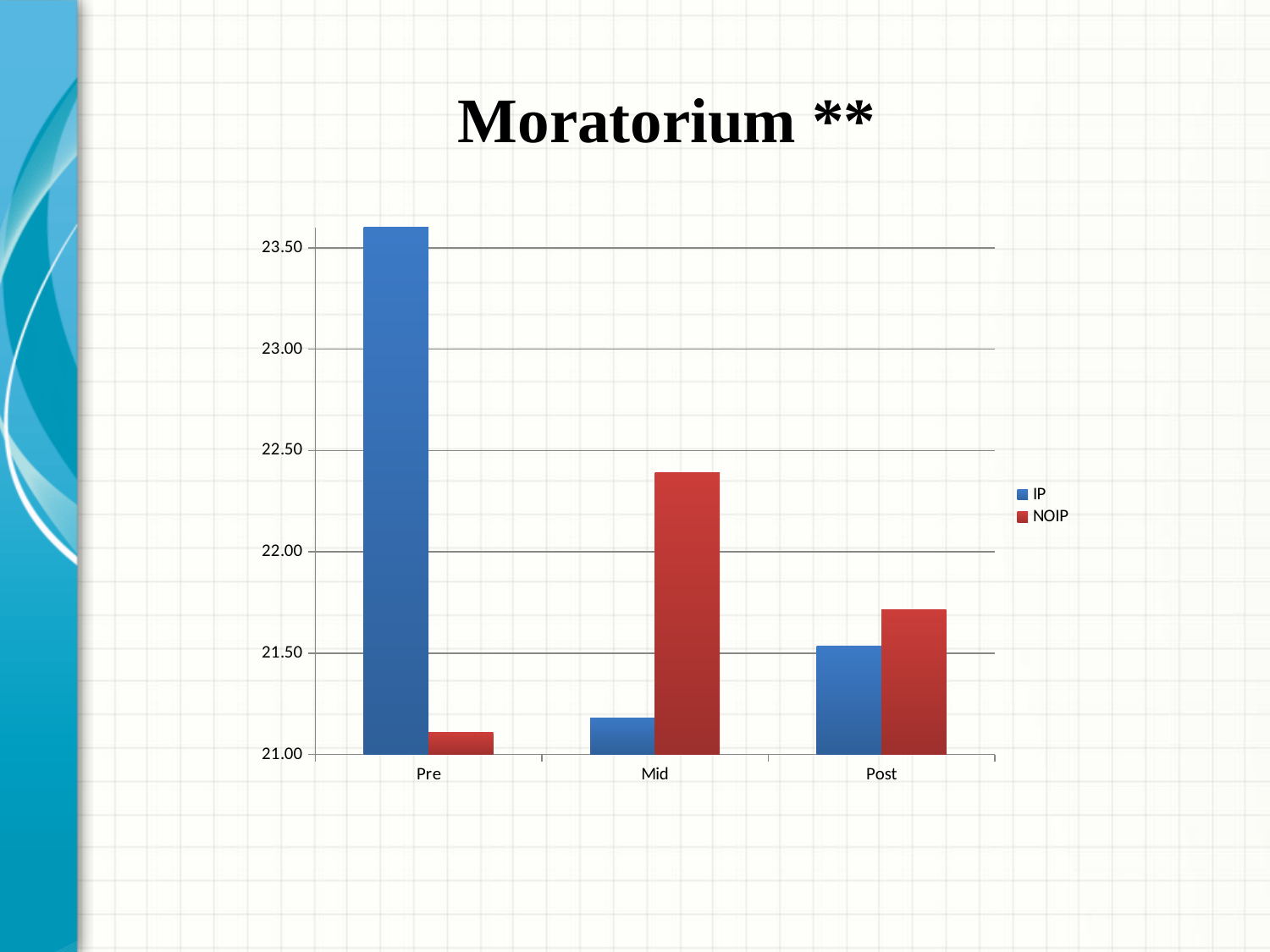
For the Mid category, which series has the larger value, IP or NOIP? NOIP Is the IP value for Pre greater or less than 23.00? greater What kind of chart is shown on the slide? Bar chart Which category has the highest NOIP value? Mid Which category has the highest IP value? Pre How many series does the legend list? 2 Is the NOIP value for Mid greater or less than 22.50? less Which category has the lowest NOIP value? Pre How many categories are shown on the x axis? 3 What is the title of the chart? Moratorium ** Which category has the lowest IP value? Mid For the Pre category, which series has the larger value, IP or NOIP? IP